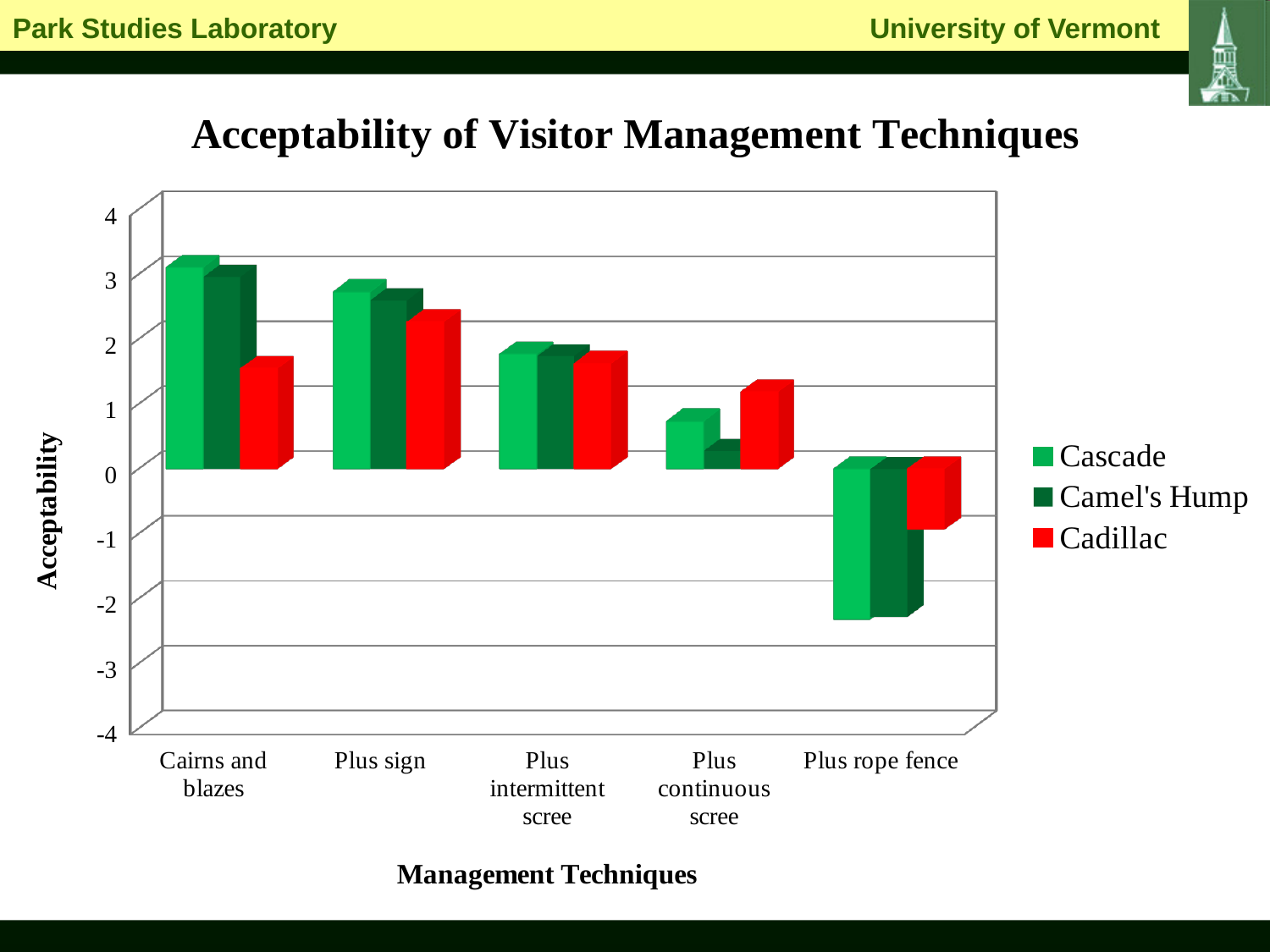
Do the Cascade values rise or fall moving from Cairns and blazes to Plus rope fence along the x axis? fall For Cairns and blazes, which is larger: the Cascade value or the Cadillac value? Cascade How many series does the legend list? 3 Is the Cascade value for Cairns and blazes greater or less than 2? greater Is the Cadillac value for Plus rope fence greater or less than 0? less Which management technique has the highest acceptability for Cascade? Cairns and blazes For Plus continuous scree, which is larger: the Cadillac value or the Camel's Hump value? Cadillac Which management technique has the highest acceptability for Cadillac? Plus sign What kind of chart is shown on the slide? Bar chart Which management technique has the lowest acceptability for Cascade? Plus rope fence How many management techniques are shown on the x axis? 5 What is the title of the vertical axis? Acceptability